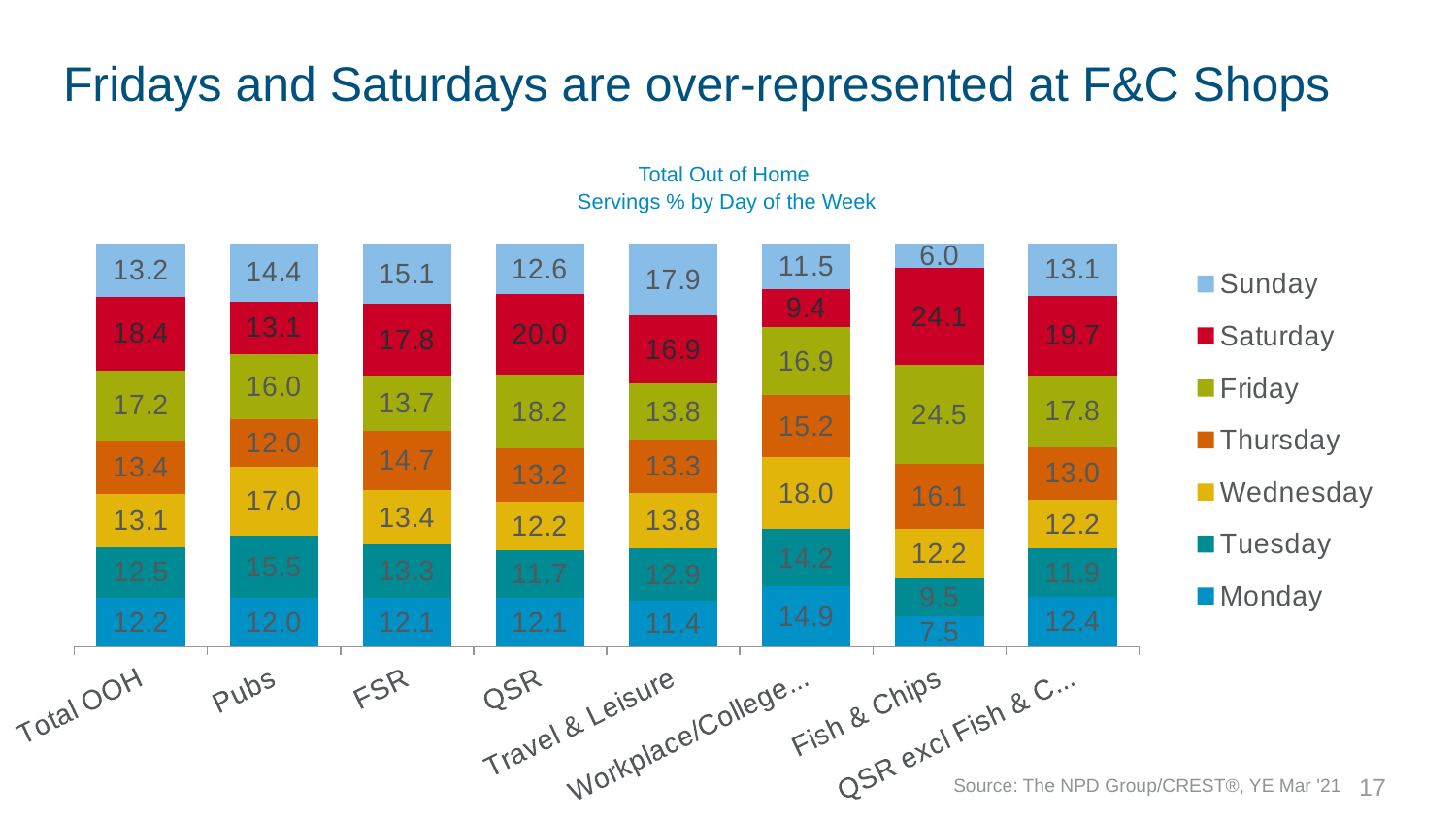
What is the difference between the Friday value for Fish & Chips and the Friday value for Total OOH? 7.3 What is the Wednesday value for Pubs? 17.0 How many categories are shown on the x axis? 8 What is the Friday value for Total OOH? 17.2 What is the total of the stacked bar for Total OOH? 100.0 Which is larger for Workplace/College: the Saturday value or the Sunday value? Sunday What is the title of the chart? Total Out of Home Servings % by Day of the Week What is the Saturday value for Fish & Chips? 24.1 Which category has the highest Friday value? Fish & Chips How many series does the legend list? 7 Which category has the lowest Sunday value? Fish & Chips What kind of chart is shown on the slide? Stacked bar chart